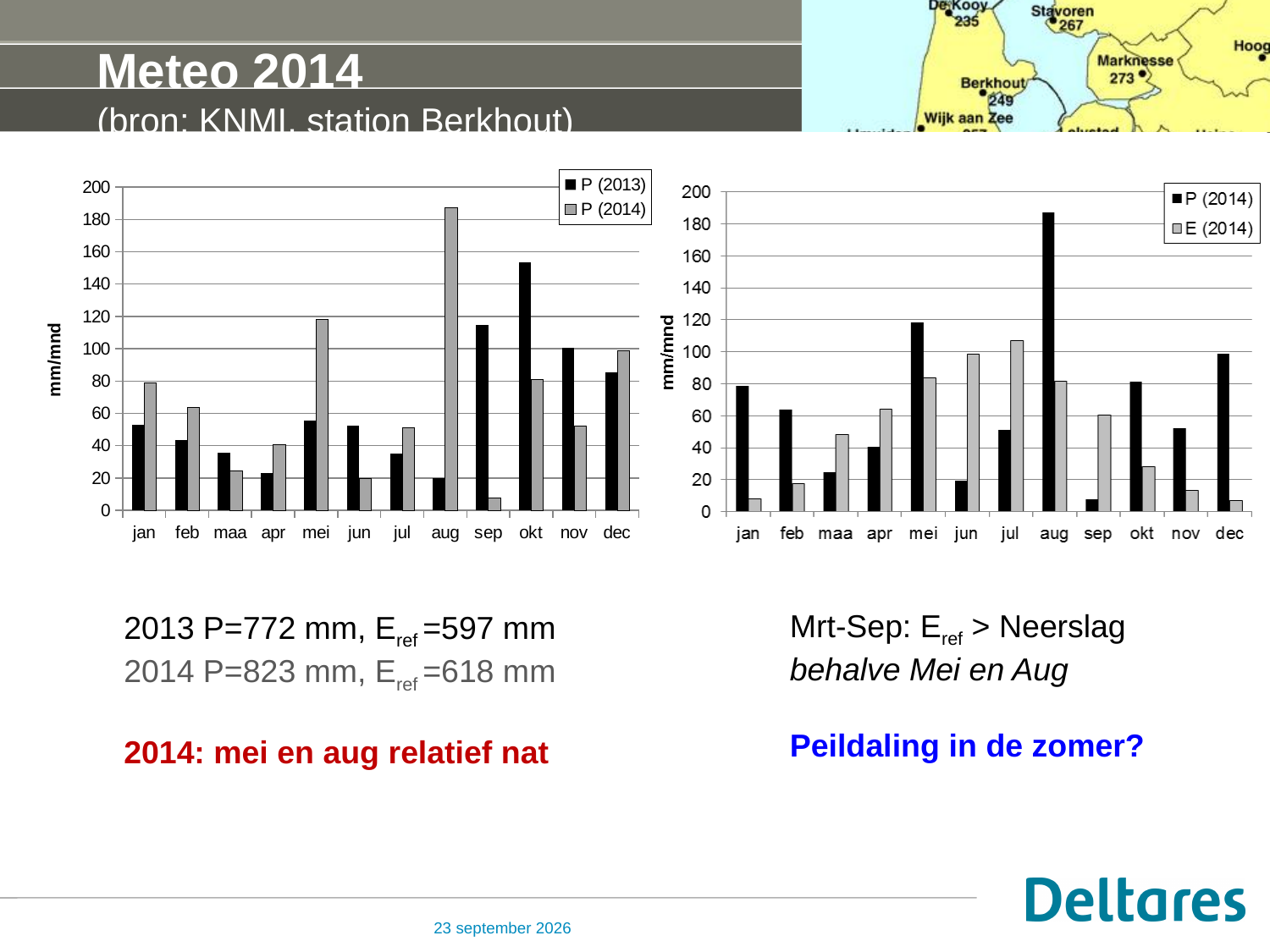
In the left chart, which month has the lowest P (2014) value? sep In the right chart, is the E (2014) value for jul greater or less than 100? greater What kind of chart is the left chart on the slide? bar chart In the left chart, which month has the highest P (2013) value? okt In the left chart, which month has the highest P (2014) value? aug In the right chart, is the E (2014) value for jan greater or less than 20? less How many months are shown on the x axis of the left chart? 12 What is the y-axis label of the right chart? mm/mnd In the right chart, which is larger for jun: P (2014) or E (2014)? E (2014) How many series does the legend of the right chart list? 2 In the left chart, is the P (2014) value for aug greater or less than 180? greater